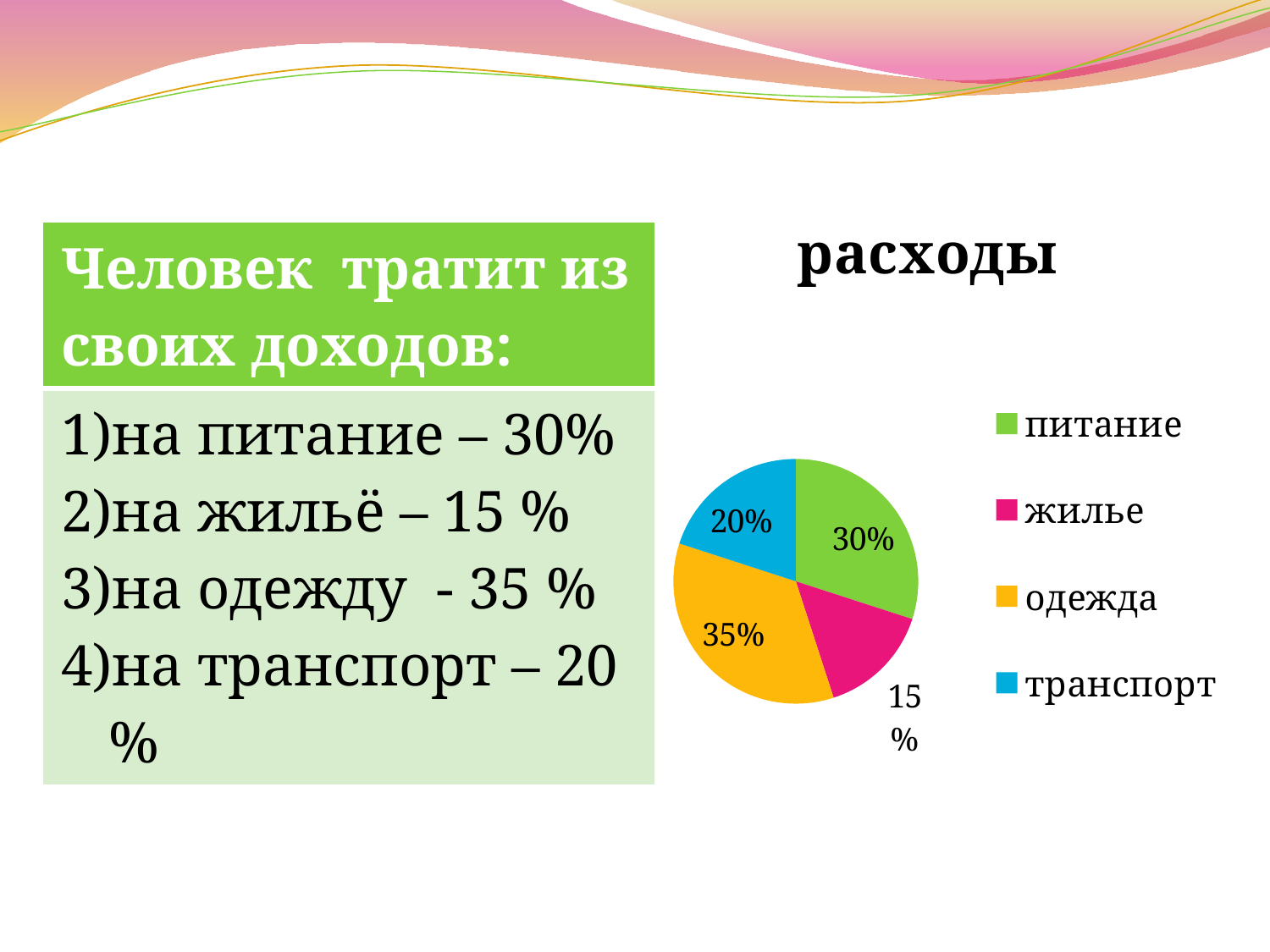
What share of the pie does одежда take? 35% Which is larger, the share for питание or the share for транспорт? питание What is the difference between the shares for одежда and жилье? 20% Which category has the smallest slice of the pie? жилье How many slices does the pie chart have? 4 What share of the pie does транспорт take? 20% What is the title of the chart? расходы What share of the pie does жилье take? 15% Which category has the largest slice of the pie? одежда What share of the pie does питание take? 30% What colour is the slice for транспорт? blue What type of chart is shown on the slide? pie chart